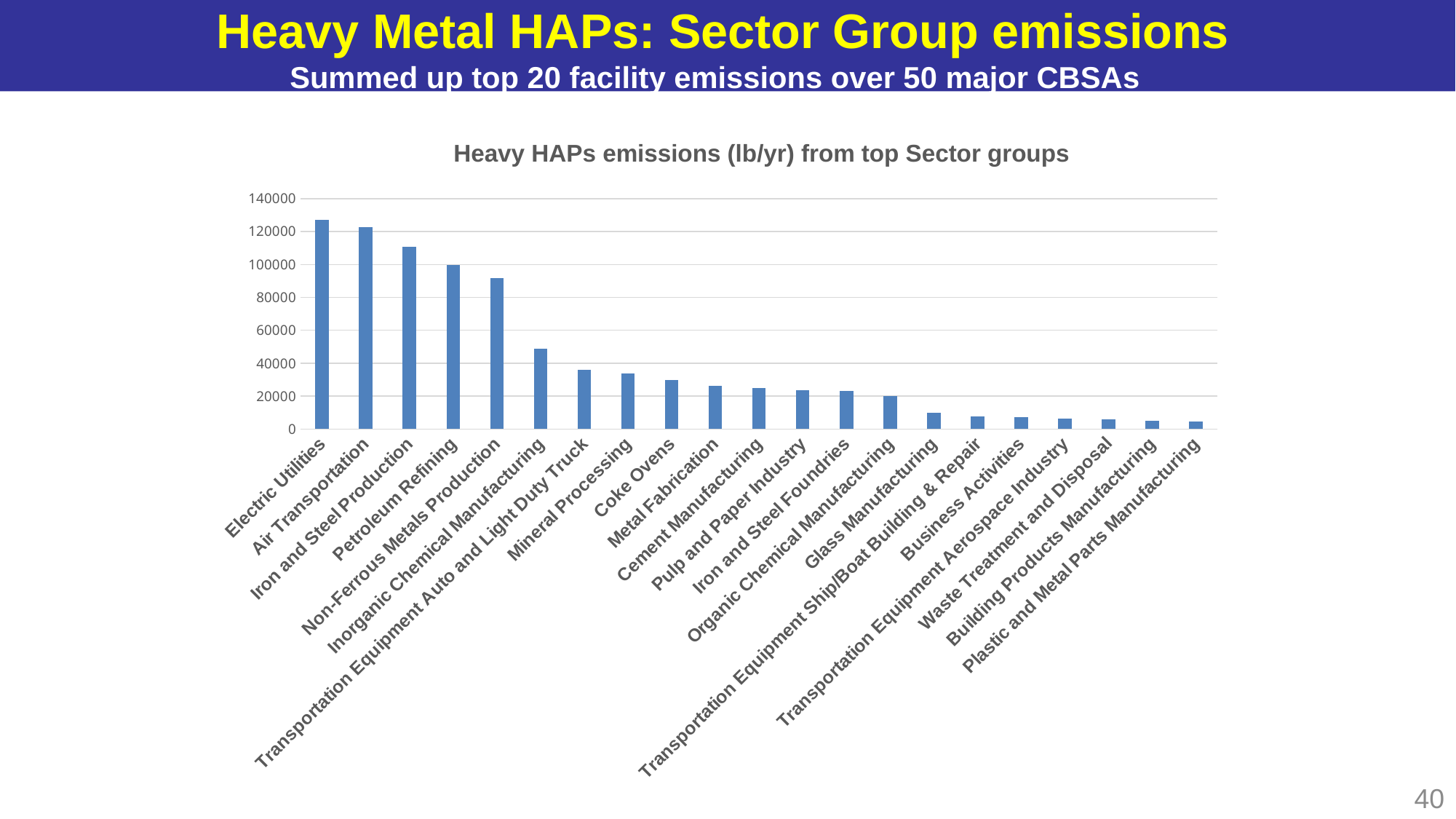
What kind of chart is shown on the slide? Bar chart What is the title of the chart? Heavy HAPs emissions (lb/yr) from top Sector groups Is the value for Business Activities greater or less than 20000? less Is the value for Electric Utilities greater or less than 120000? greater How many sector groups are plotted in the chart? 21 Is the value for Mineral Processing greater or less than 40000? less Which has higher emissions, Air Transportation or Iron and Steel Production? Air Transportation Which sector group has the highest emissions in the chart? Electric Utilities Do the values rise or fall moving from left to right along the x axis? Fall